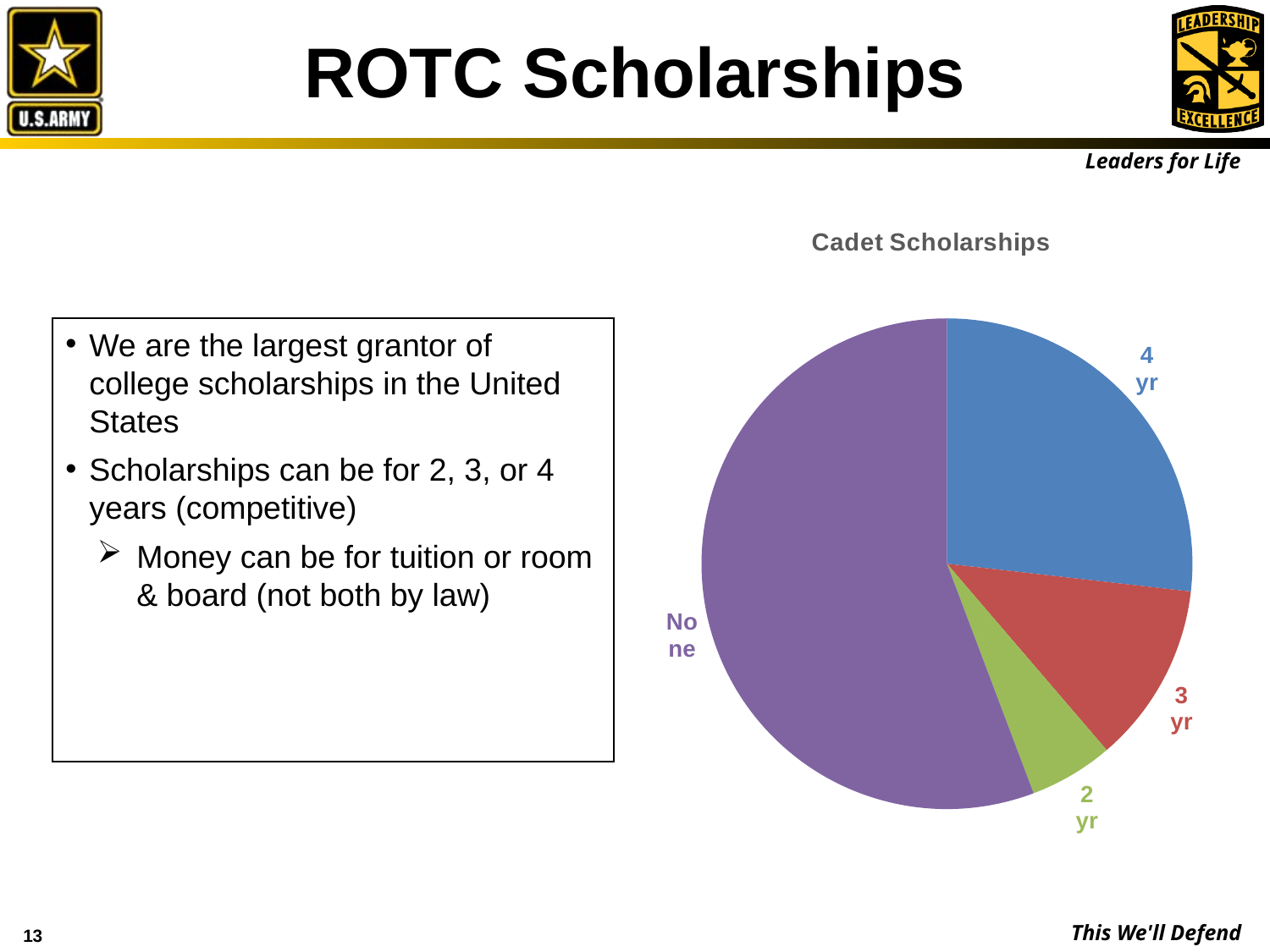
Which slice is larger, None or 4 yr? None Which category has the largest slice of the pie? None What kind of chart is shown on the slide? Pie chart Which category has the smallest slice of the pie? 2 yr Which slice is larger, 3 yr or 2 yr? 3 yr What is the title of the chart? Cadet Scholarships How many slices does the pie chart have? 4 Which category is the second-largest slice of the pie? 4 yr Which slice is larger, 4 yr or 3 yr? 4 yr What colour is the slice labelled None? Purple